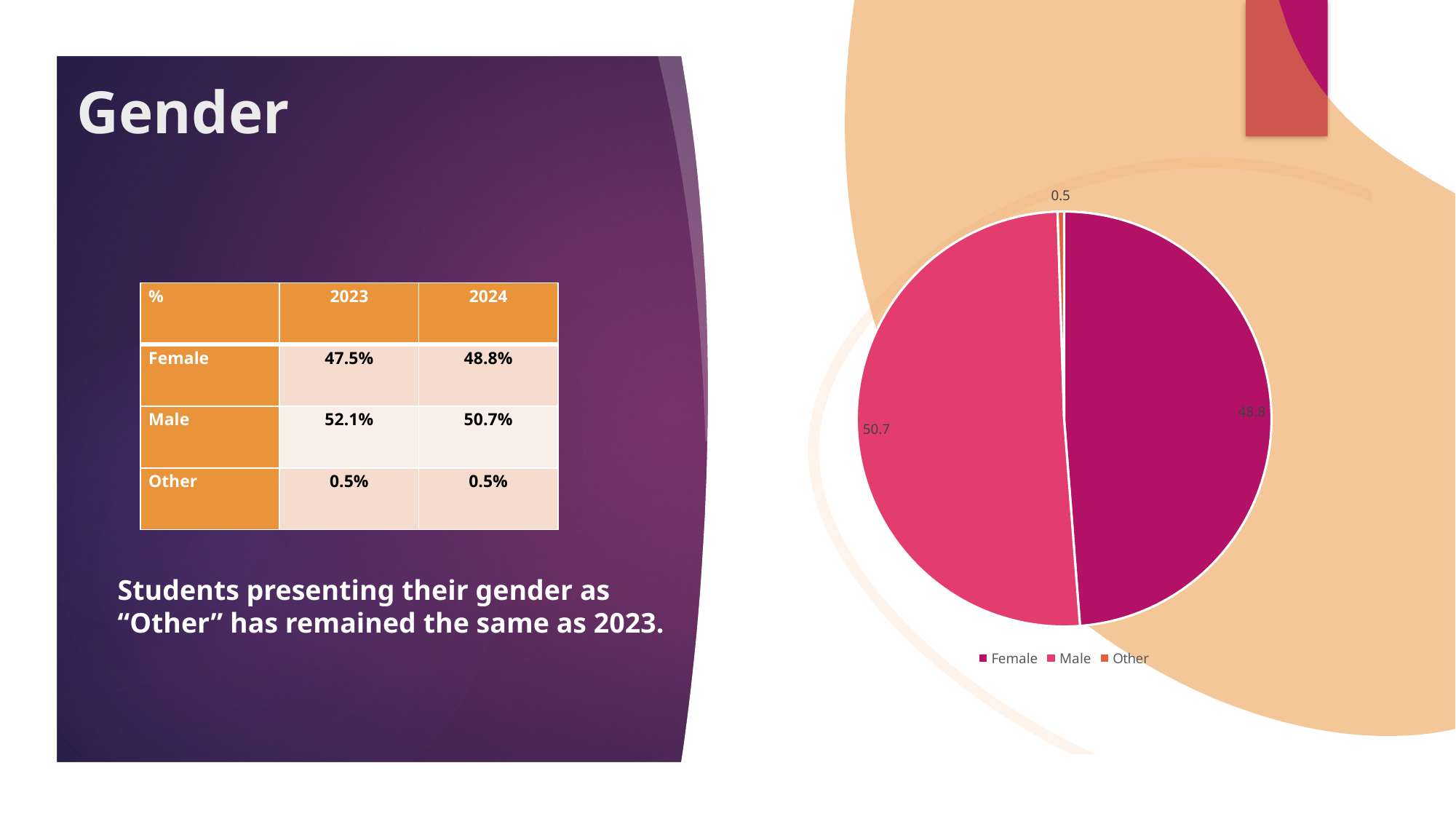
What kind of chart is shown on the slide? pie chart What is the value for Male in the pie chart? 50.7 Which category has the smallest slice in the pie chart? Other What is the value for Other in the pie chart? 0.5 What is the value for Female in the pie chart? 48.8 What is the difference between the Female and Other values in the pie chart? 48.3 Which legend entry is listed first in the pie chart's legend? Female Which category has the largest slice in the pie chart? Male How many entries does the legend of the pie chart list? 3 Which is larger in the pie chart, Female or Male? Male What is the difference between the Male and Female values in the pie chart? 1.9 How many slices does the pie chart have? 3